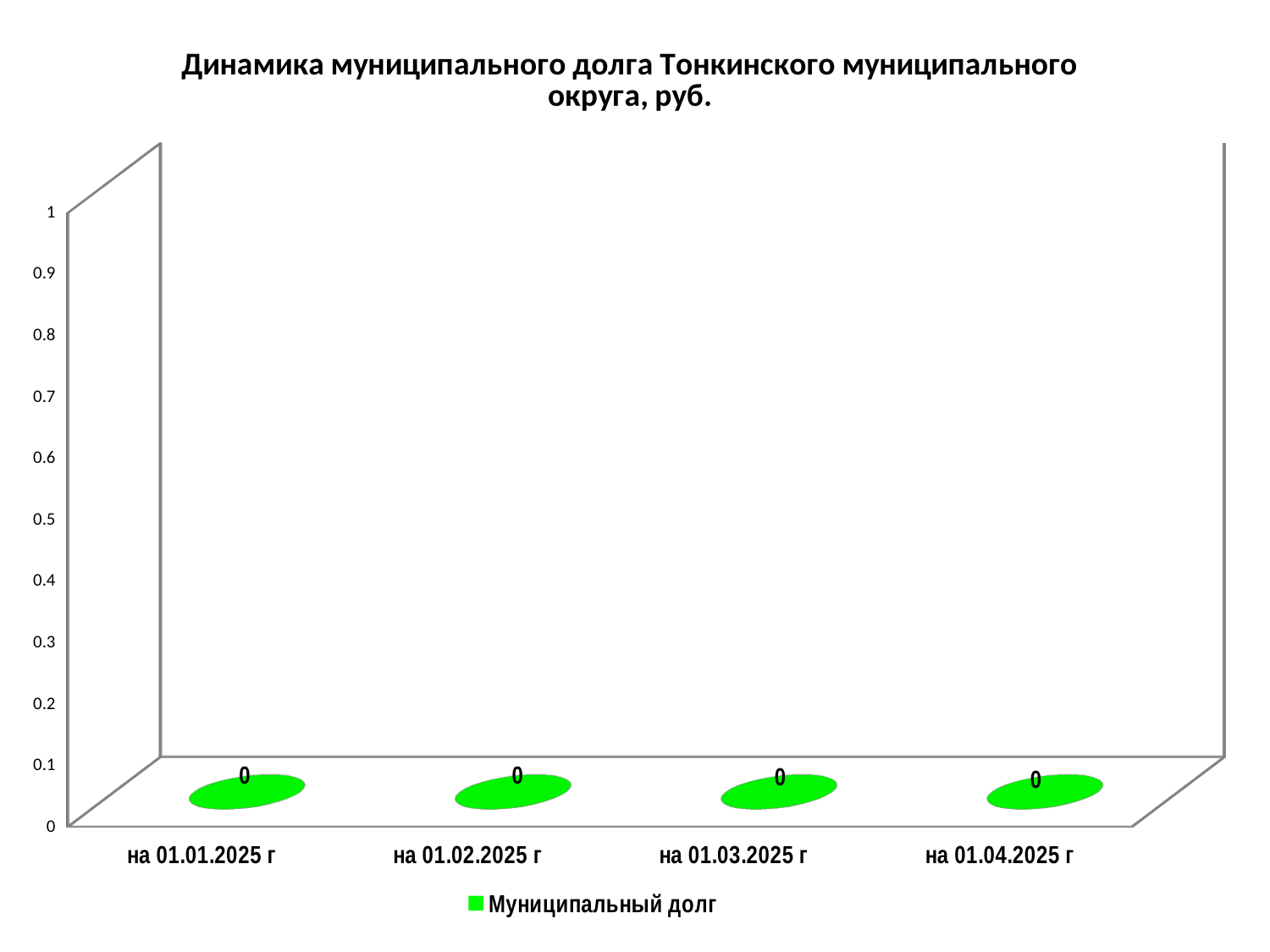
What series name is listed in the legend? Муниципальный долг What is the value shown for на 01.03.2025 г? 0 Is the value for на 01.02.2025 г greater or less than 0.5? less What is the value of Муниципальный долг на 01.01.2025 г? 0 What is the highest tick value shown on the vertical axis? 1 Do the values rise, fall, or stay the same from на 01.01.2025 г to на 01.04.2025 г? stay the same What is the title of the chart? Динамика муниципального долга Тонкинского муниципального округа, руб. How many series does the legend list? 1 What is the value of Муниципальный долг на 01.04.2025 г? 0 What is the difference between the values for на 01.02.2025 г and на 01.01.2025 г? 0 What kind of chart is shown on the slide? bar chart How many categories (dates) are shown on the x axis? 4